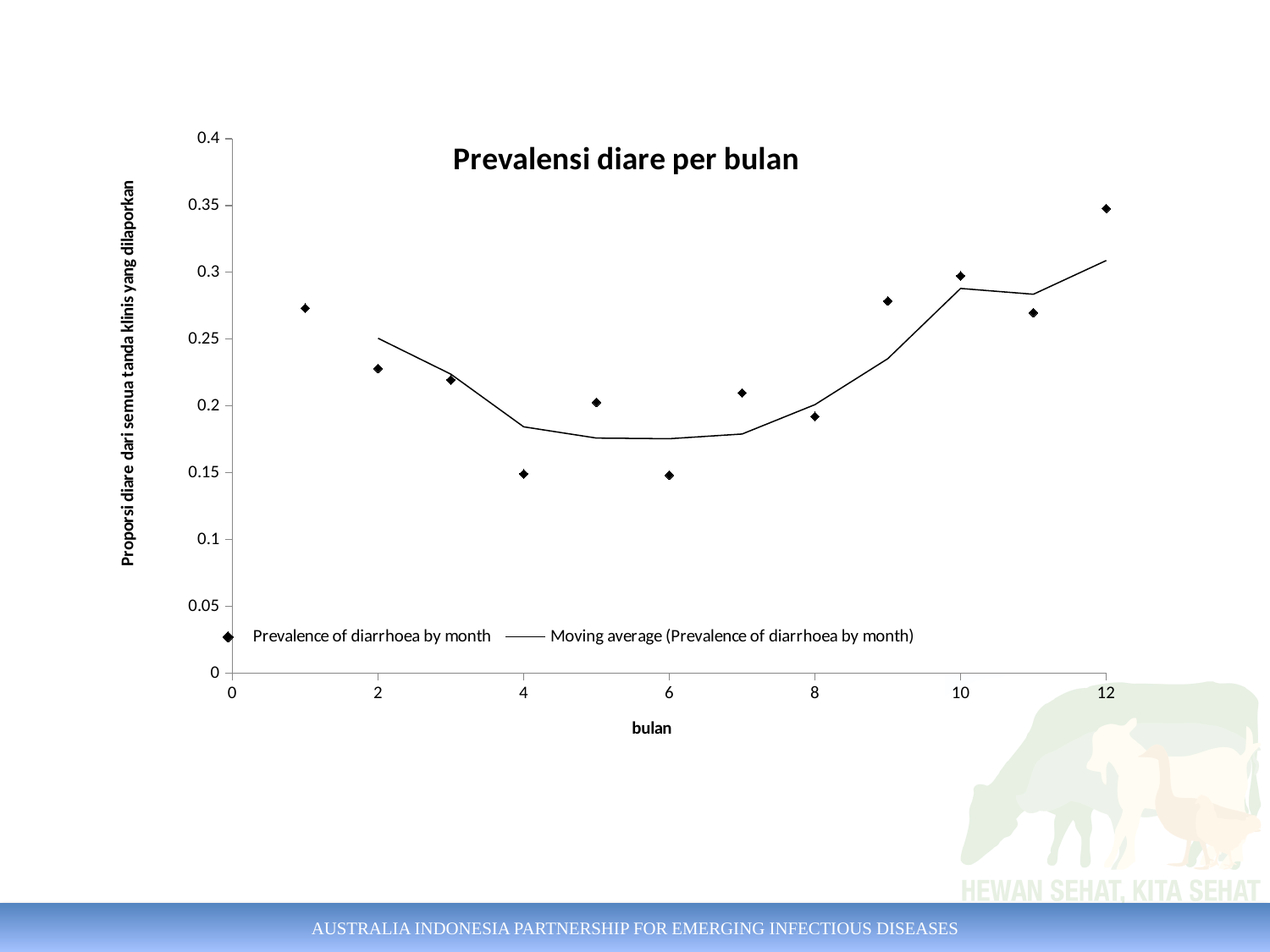
Which month has the highest prevalence of diarrhoea? 12 Is the prevalence value for month 4 greater or less than 0.2? less How many series does the legend list? 2 Is the prevalence value for month 12 greater or less than 0.3? greater Which has the higher prevalence value, month 4 or month 5? Month 5 What is the label on the x axis? bulan What kind of chart is shown on the slide? Scatter chart with a moving average line Do the prevalence values generally rise or fall from month 6 to month 12? Rise What is the title of the chart? Prevalensi diare per bulan How many data points are plotted for 'Prevalence of diarrhoea by month'? 12 Is the prevalence value for month 6 greater or less than 0.2? less